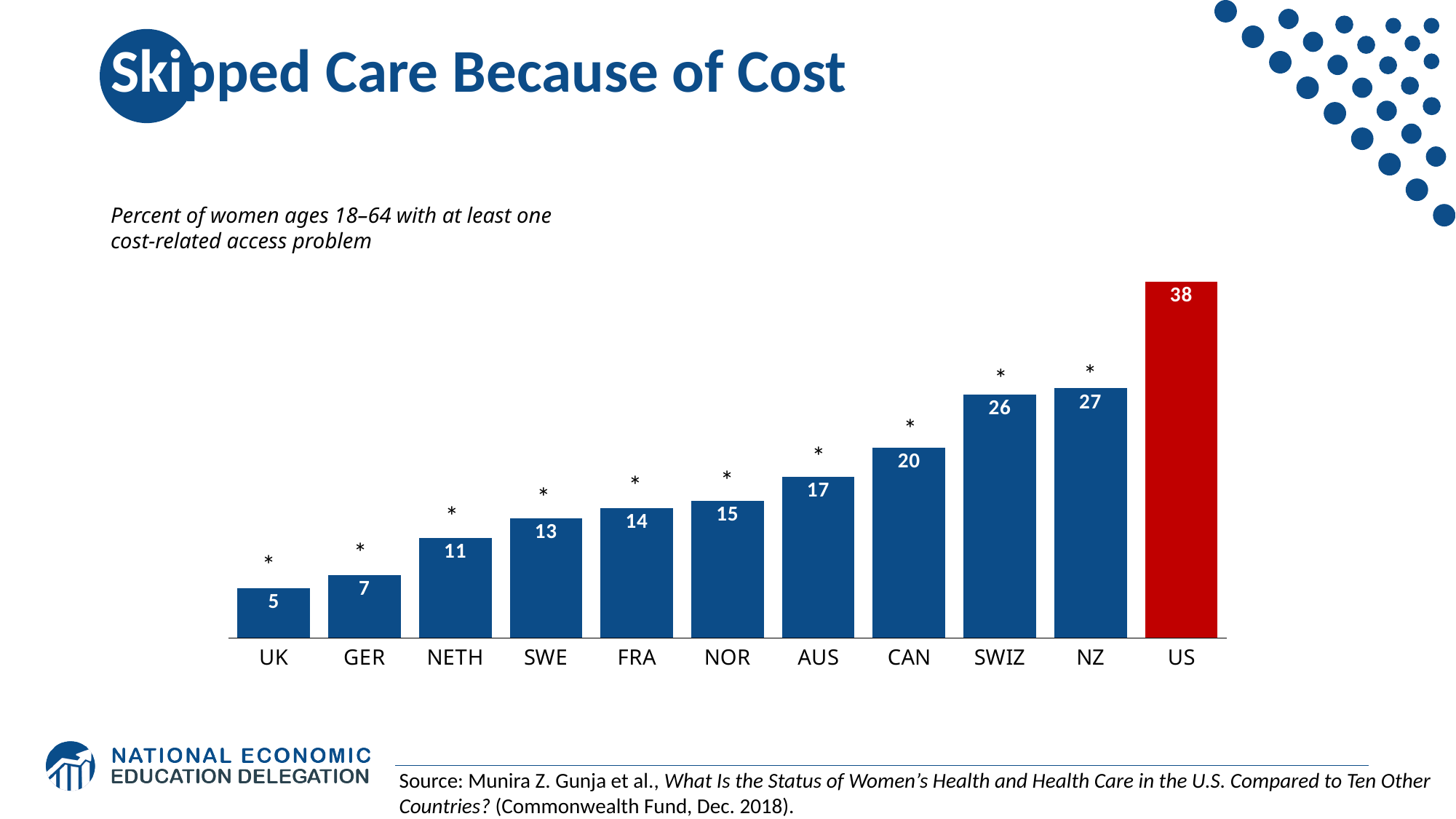
What is the value for the US? 38 What is the value for Canada (CAN)? 20 How many countries are shown in the chart? 11 What is the value for Germany (GER)? 7 Which country has the highest value? US Which has a larger value, AUS or NOR? AUS Which bar is coloured red rather than blue? US Which country has the lowest value? UK What kind of chart is shown on the slide? Bar chart What is the difference between the values for the US and NZ? 11 Do the values rise or fall from left to right across the countries? Rise What is the difference between the values for SWE and UK? 8